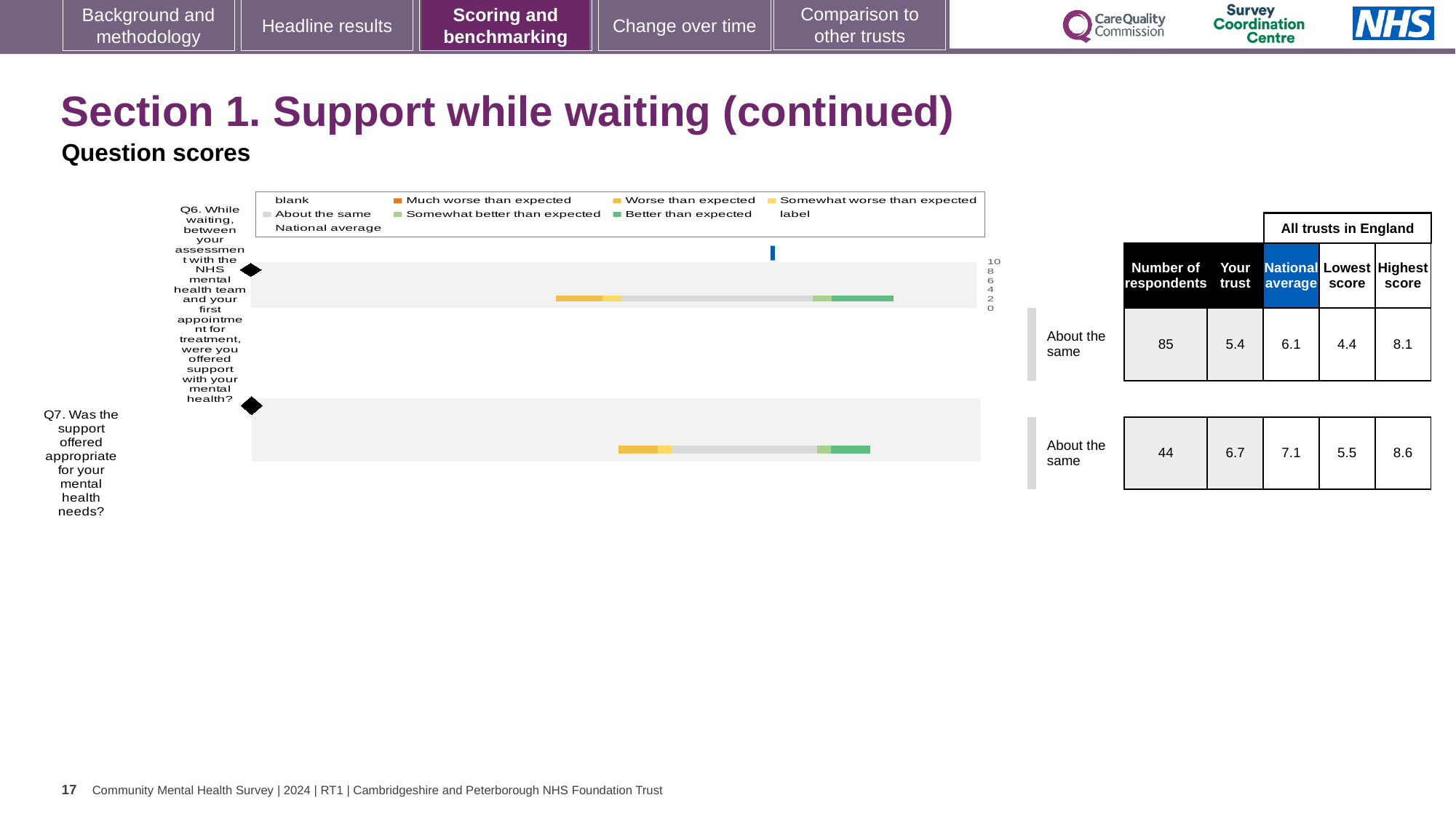
By how much does the national average exceed the 'Your trust' score for Q6? 0.7 What is the difference between the highest and lowest scores for Q7? 3.1 Which question has the higher 'Your trust' score, Q6 or Q7? Q7 How many questions are plotted in the chart? 2 What is the highest score among all trusts in England for Q6? 8.1 What benchmarking category is shown for Q7? About the same For Q6, which is larger: the 'Your trust' score or the national average? National average What is the 'Your trust' score for Q6? 5.4 What is the national average score for Q7? 7.1 How many respondents answered Q6? 85 What is the lowest score among all trusts in England for Q7? 5.5 What type of chart is used to show the question scores for Q6 and Q7? bar chart